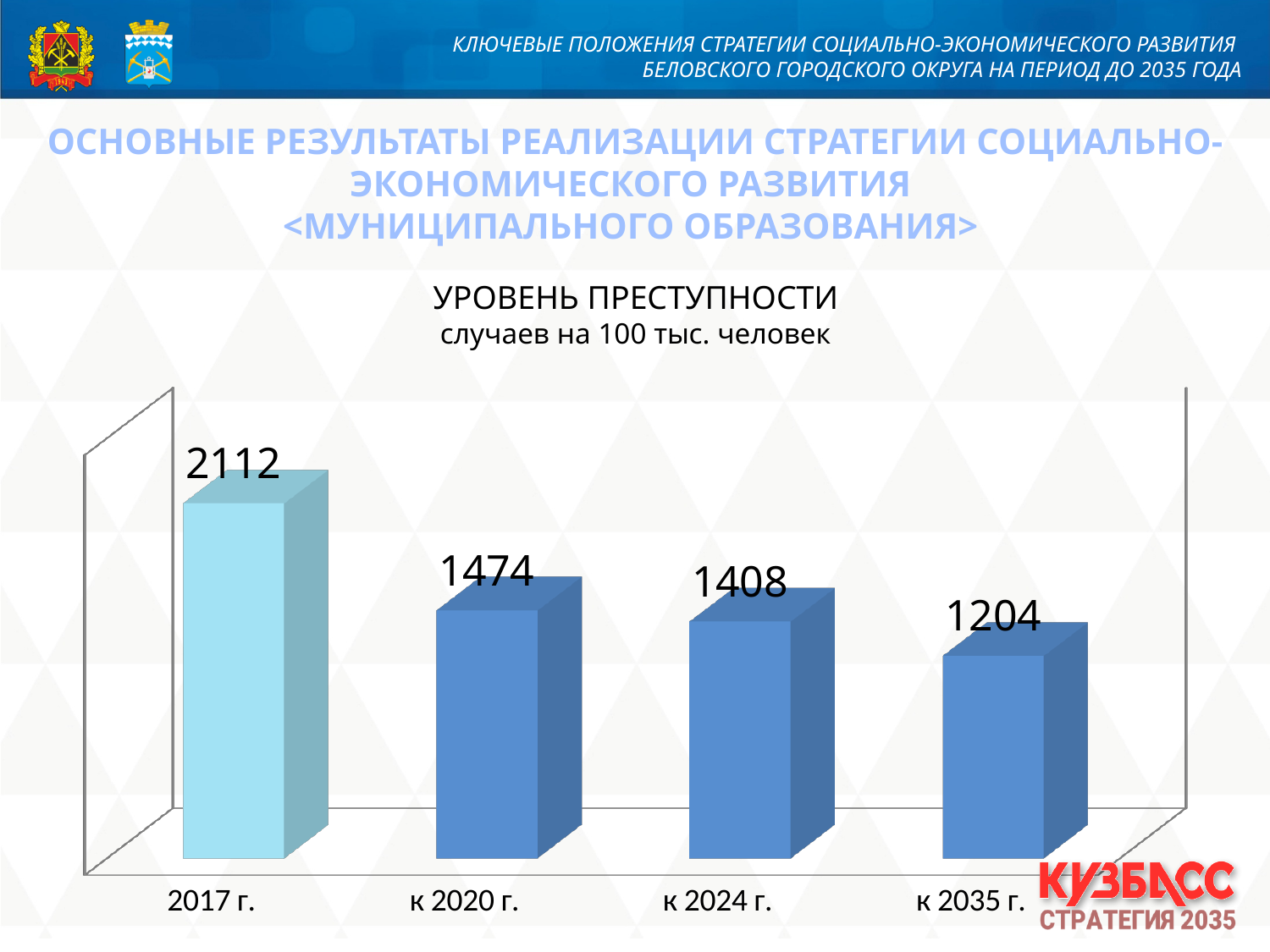
What kind of chart is this? bar chart What is the difference between the values for к 2020 г. and к 2024 г.? 66 What value is shown for к 2035 г.? 1204 Which category has the highest value? 2017 г. What is the crime rate value shown for 2017 г.? 2112 How many categories are shown on the chart? 4 What value is shown for к 2020 г.? 1474 What value is shown for к 2024 г.? 1408 What is the difference between the values for 2017 г. and к 2035 г.? 908 Which is larger, the value for к 2020 г. or the value for к 2035 г.? к 2020 г. Which category has the lowest value? к 2035 г. Do the values rise or fall from 2017 г. to к 2035 г.? fall